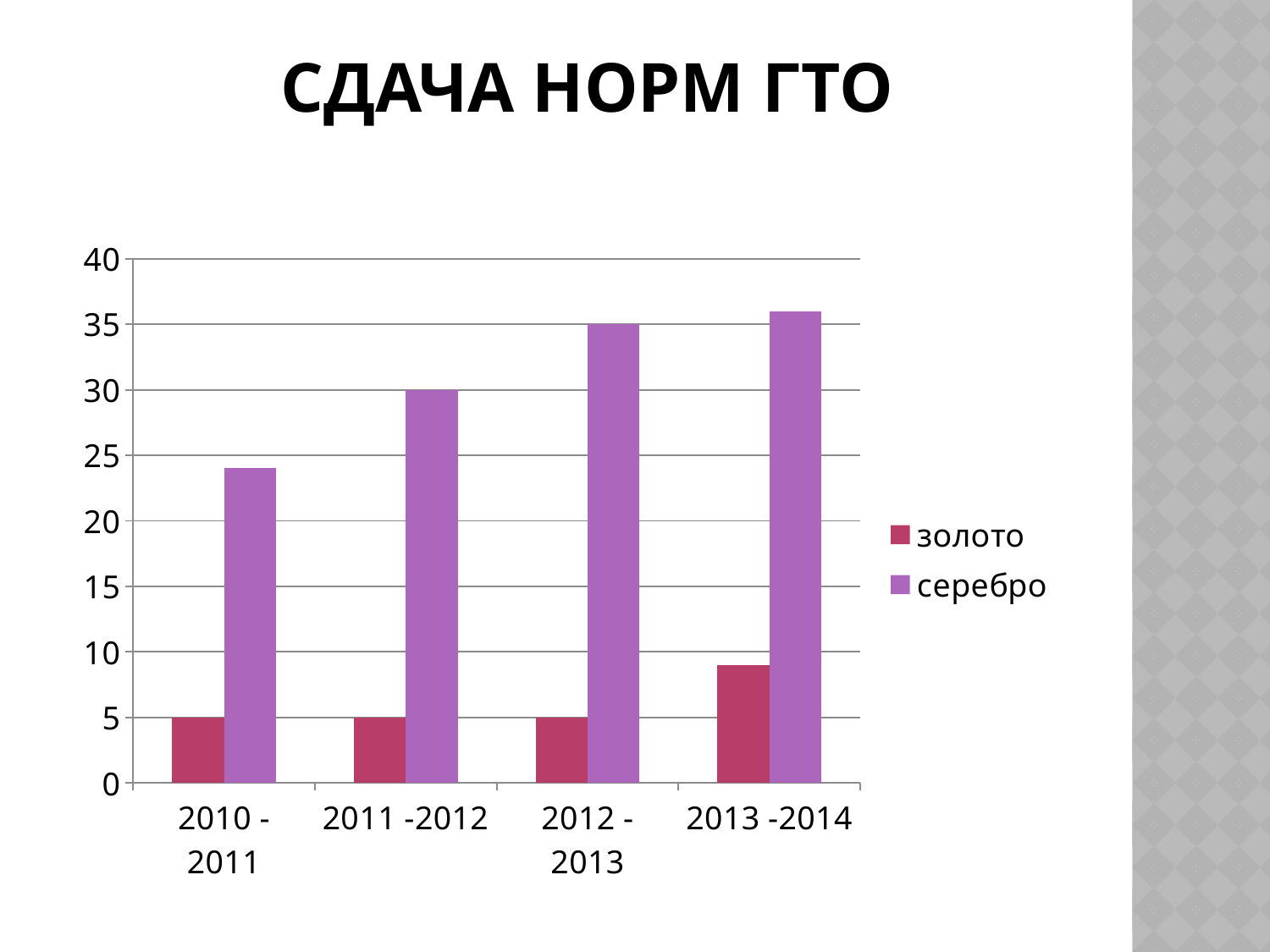
Which year has the highest value for золото? 2013 -2014 How many series does the legend list? 2 What is the value for золото in 2010 - 2011? 5 Which year has the lowest value for серебро? 2010 - 2011 Is the value for серебро in 2010 - 2011 greater or less than 25? less Is the value for золото in 2013 -2014 greater or less than 10? less What is the value for серебро in 2011 -2012? 30 Do the values for серебро rise or fall from 2010 - 2011 to 2013 -2014? rise In 2012 - 2013, which is larger: золото or серебро? серебро How many year categories are shown on the x axis? 4 What is the value for серебро in 2012 - 2013? 35 What kind of chart is shown on the slide? bar chart